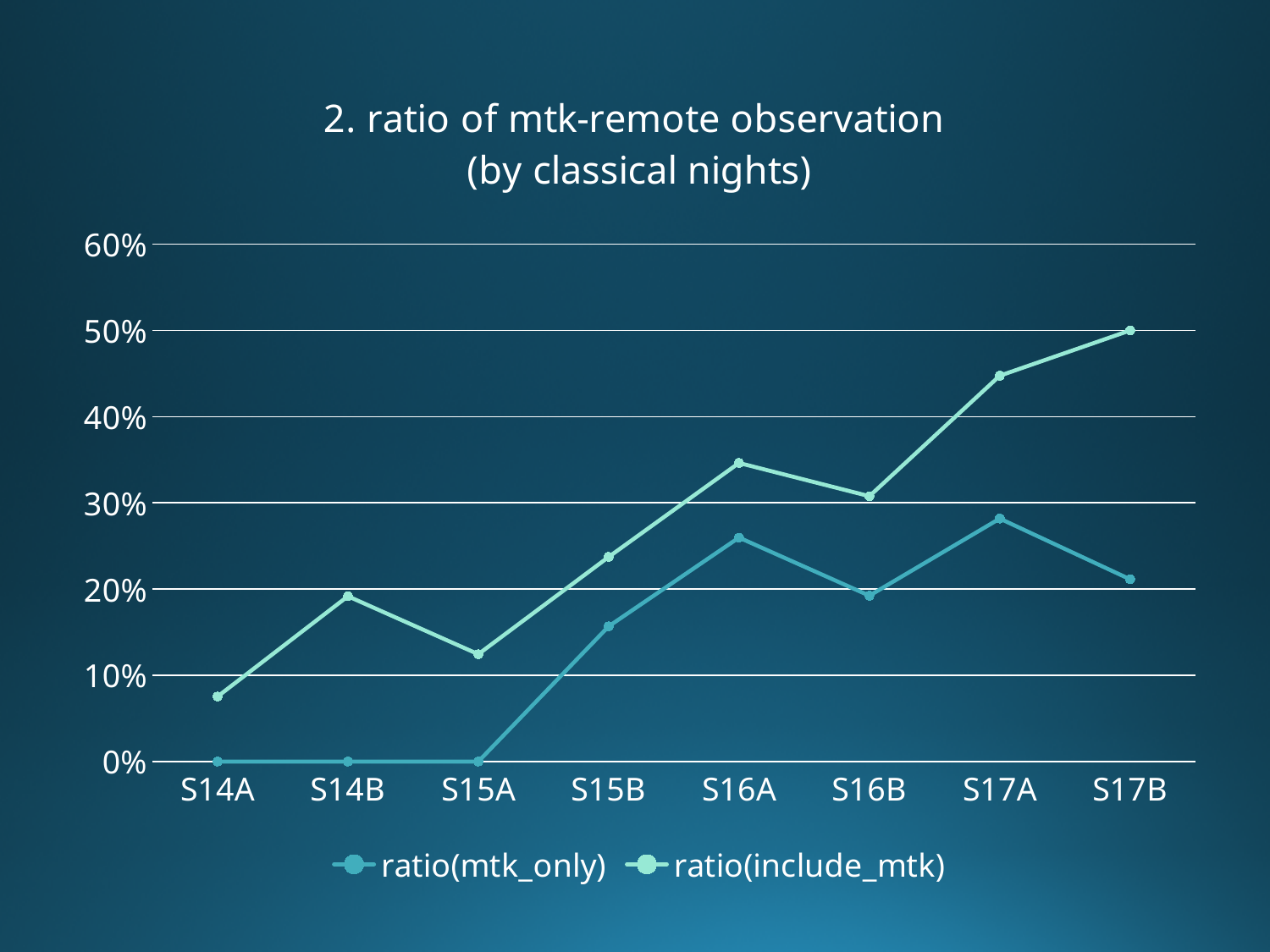
Does ratio(include_mtk) rise or fall from S16B to S17B? rise Is the value of ratio(include_mtk) at S17A greater or less than 40%? greater At which category is ratio(include_mtk) lowest? S14A Is the value of ratio(mtk_only) at S16A greater or less than 30%? less How many categories are shown on the x axis? 8 How many series does the legend list? 2 What is the value of ratio(mtk_only) at S15A? 0% At which category is ratio(mtk_only) highest? S17A At which category is ratio(include_mtk) highest? S17B What is the value of ratio(mtk_only) at S14A? 0% What is the value of ratio(include_mtk) at S17B? 50% What kind of chart is shown on the slide? line chart